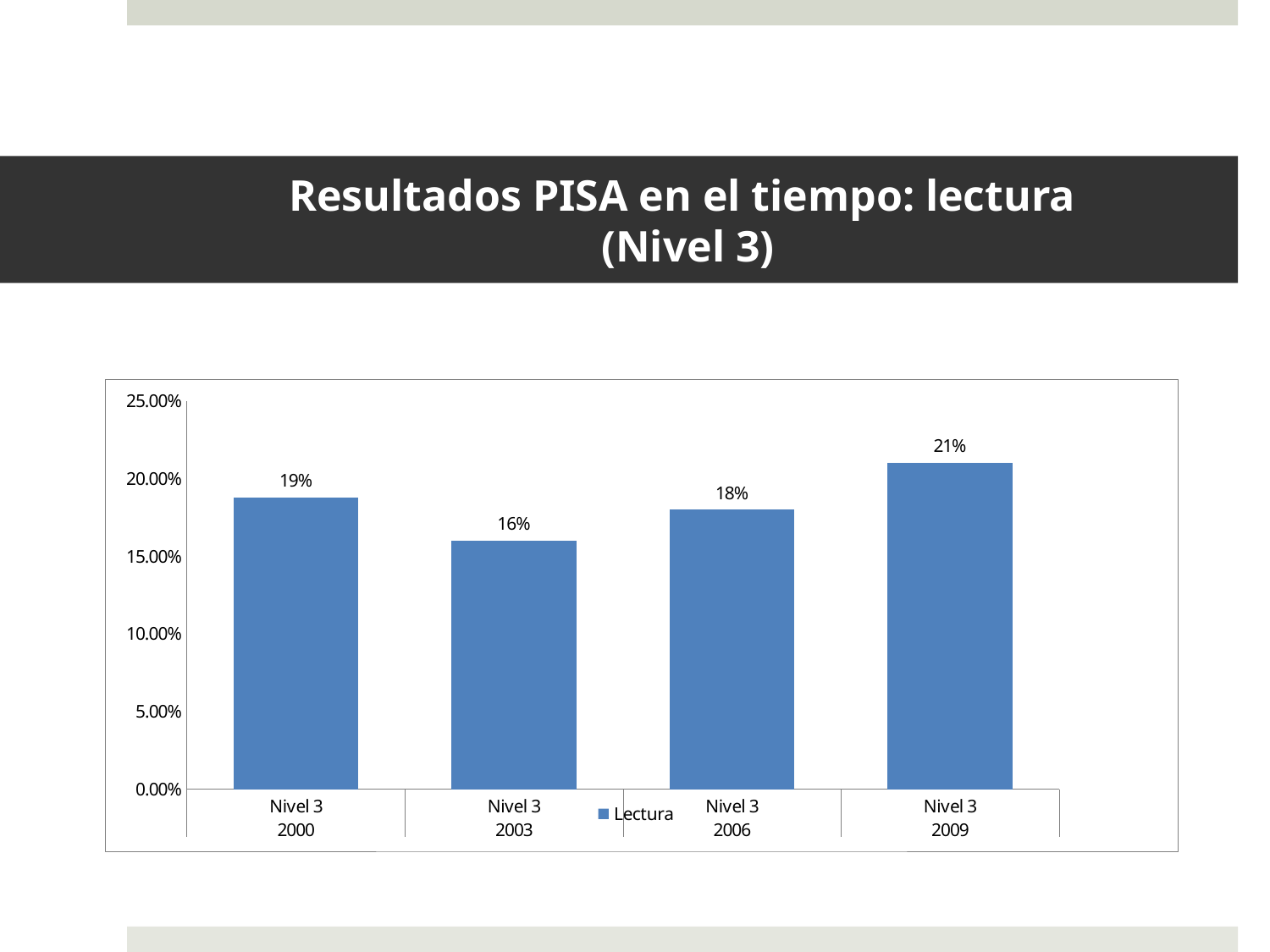
Is the value for Nivel 3 2009 greater or less than 20.00%? greater What kind of chart is shown on the slide? bar chart How many categories are shown on the chart? 4 Which is larger, the value for Nivel 3 2000 or Nivel 3 2006? Nivel 3 2000 Which category has the highest value? Nivel 3 2009 Which category has the lowest value? Nivel 3 2003 What is the value for Nivel 3 2006? 18% What is the value for Nivel 3 2000? 19% What is the value for Nivel 3 2003? 16% What is the value for Nivel 3 2009? 21% What series name does the legend show? Lectura What is the difference between the values for Nivel 3 2009 and Nivel 3 2003? 5%